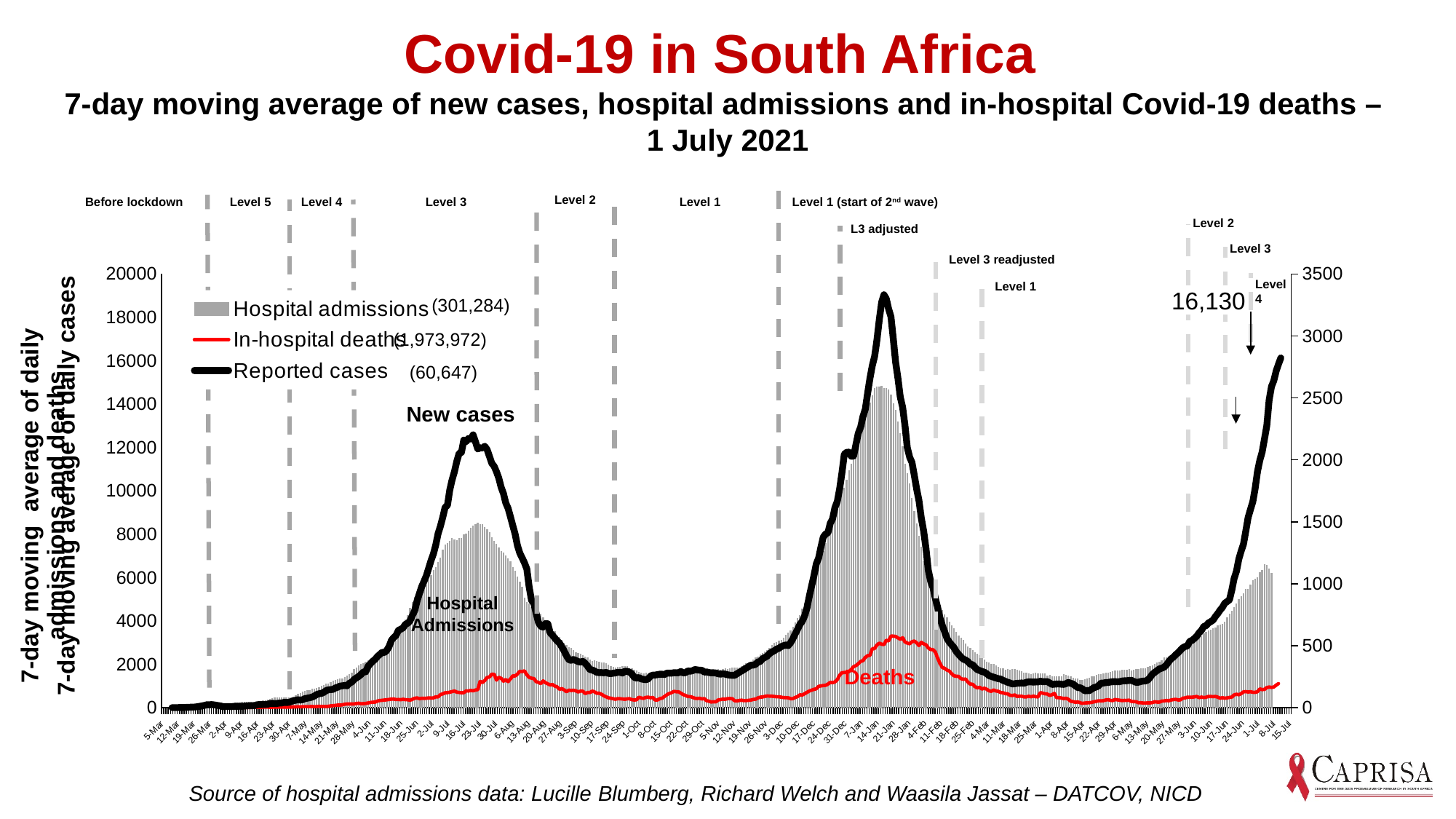
What value is printed with an arrow near the end of the Reported cases line? 16,130 Which was higher: the peak of Reported cases in the first wave (July 2020) or in the second wave (January 2021)? Second wave (January 2021) What colour is the Reported cases line? Black Do Reported cases rise or fall between 14-Jan and 4-Mar 2021? Fall Do Reported cases rise or fall between 10-Jun and 8-Jul 2021? Rise Is the peak of the Reported cases line in January 2021 greater or less than 18000? greater How many series does the legend list? 3 What number is printed in parentheses next to Hospital admissions in the legend? 301,284 What kind of chart is this? Combined bar and line chart Which was higher: the peak of Hospital admissions in the first wave (July 2020) or in the second wave (January 2021)? Second wave (January 2021) What colour is the In-hospital deaths line? Red Is the peak of the Reported cases line in July 2020 greater or less than 10000? greater